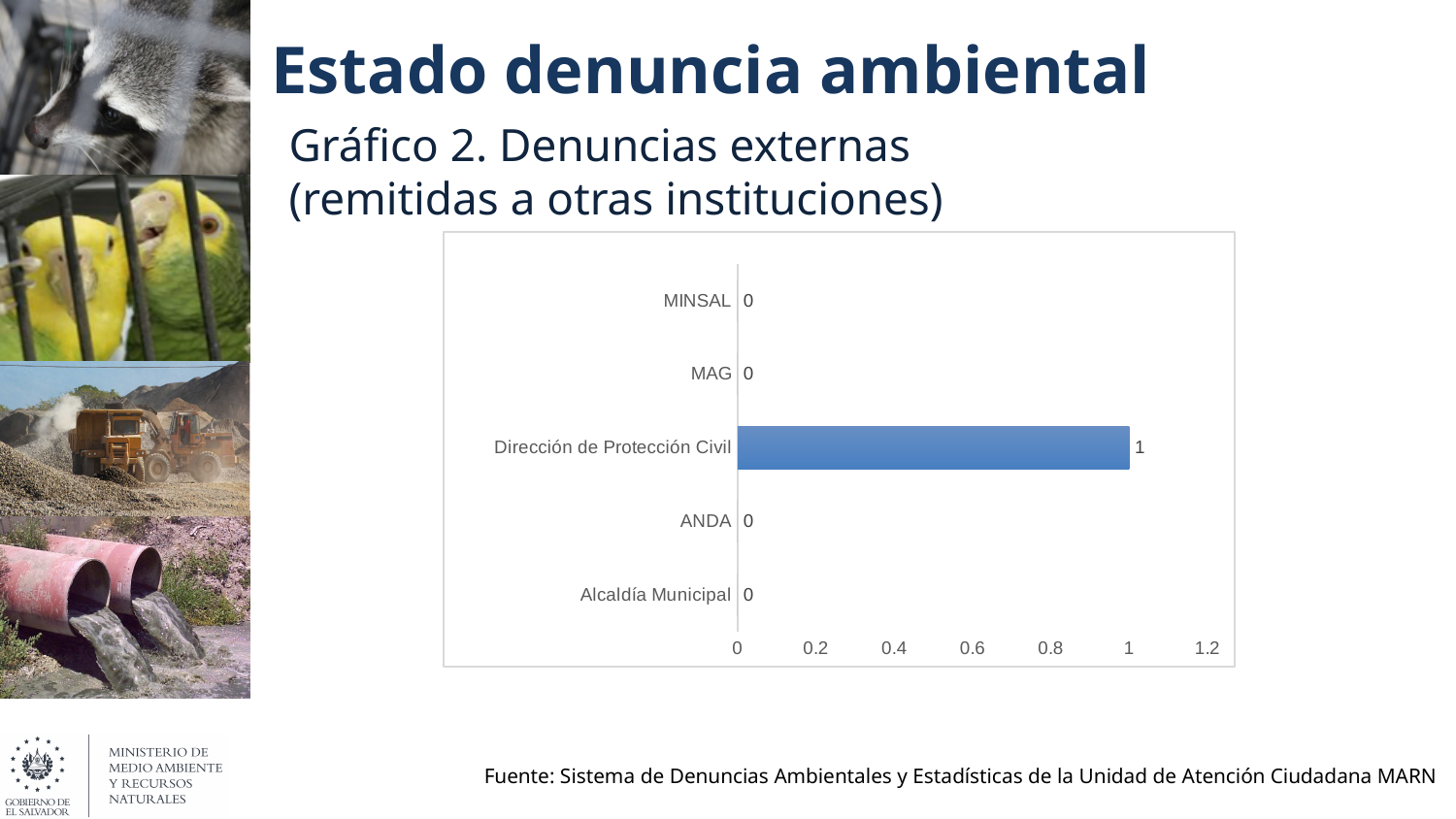
Which is larger, the value for Dirección de Protección Civil or the value for ANDA? Dirección de Protección Civil What is the value for MINSAL? 0 How many categories have a value of 0? 4 Which category has the highest value? Dirección de Protección Civil What is the value for ANDA? 0 What is the highest value shown on the x axis? 1.2 What is the difference between the values for Dirección de Protección Civil and MAG? 1 How many categories are shown in the chart? 5 What is the value for Alcaldía Municipal? 0 What kind of chart is shown on the slide? Bar chart What is the value for Dirección de Protección Civil? 1 What is the title of the chart? Gráfico 2. Denuncias externas (remitidas a otras instituciones)